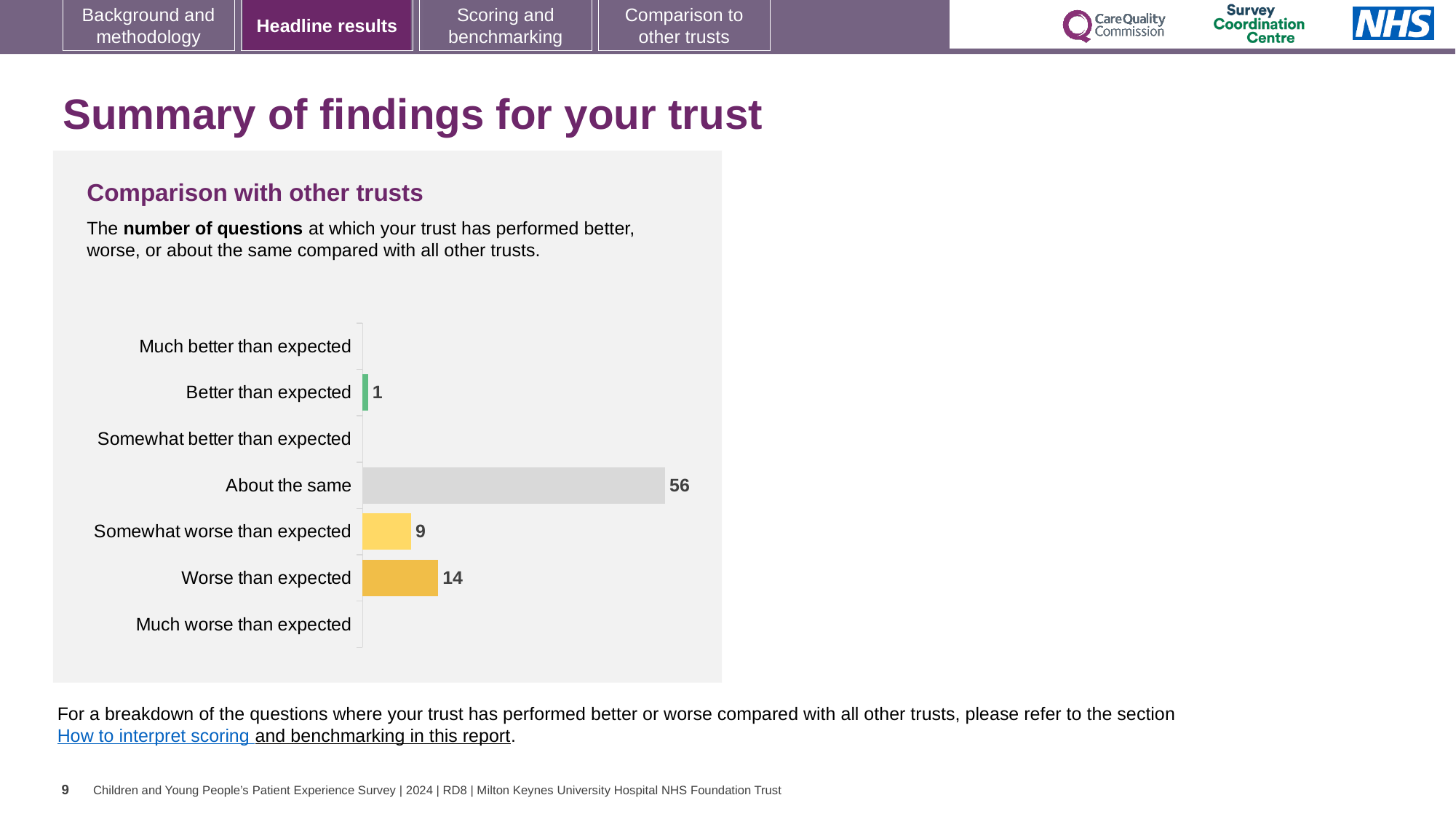
What is the value for 'Worse than expected'? 14 What is the difference between 'About the same' and 'Worse than expected'? 42 What kind of chart is shown on the slide? Bar chart What is the value for 'Better than expected'? 1 How many questions are in the 'About the same' category? 56 How many categories are listed on the chart's axis? 7 What is the title of the chart section? Comparison with other trusts Which category has the highest number of questions? About the same What is the difference between 'Worse than expected' and 'Somewhat worse than expected'? 5 What is the total of the labelled values shown on the chart? 80 Which is larger, 'Somewhat worse than expected' or 'Better than expected'? Somewhat worse than expected What is the value for 'Somewhat worse than expected'? 9